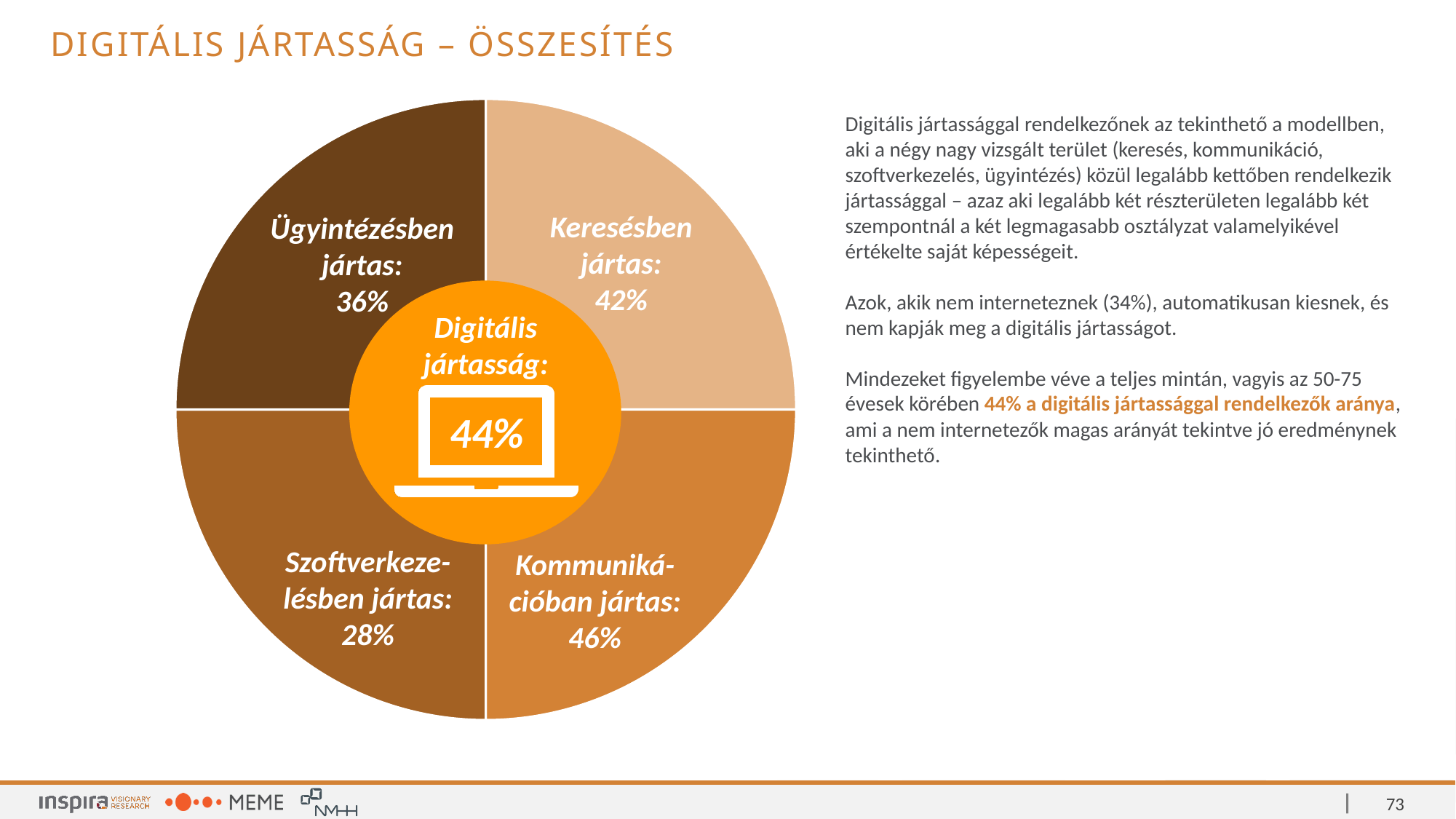
What is the difference between the percentages for "Kommunikációban jártas" and "Szoftverkezelésben jártas"? 18 percentage points What percentage is shown for "Szoftverkezelésben jártas"? 28% What is the difference between the percentages for "Keresésben jártas" and "Ügyintézésben jártas"? 6 percentage points Which is larger, the percentage for "Keresésben jártas" or for "Ügyintézésben jártas"? Keresésben jártas What is the title of the slide? DIGITÁLIS JÁRTASSÁG – ÖSSZESÍTÉS Which of the four areas has the lowest percentage? Szoftverkezelésben jártas What value is shown in the centre of the chart for "Digitális jártasság"? 44% What percentage is shown for "Kommunikációban jártas"? 46% What percentage is shown for "Keresésben jártas"? 42% How many areas of digital skill are shown around the centre of the chart? 4 What percentage is shown for "Ügyintézésben jártas"? 36% Which of the four areas has the highest percentage? Kommunikációban jártas